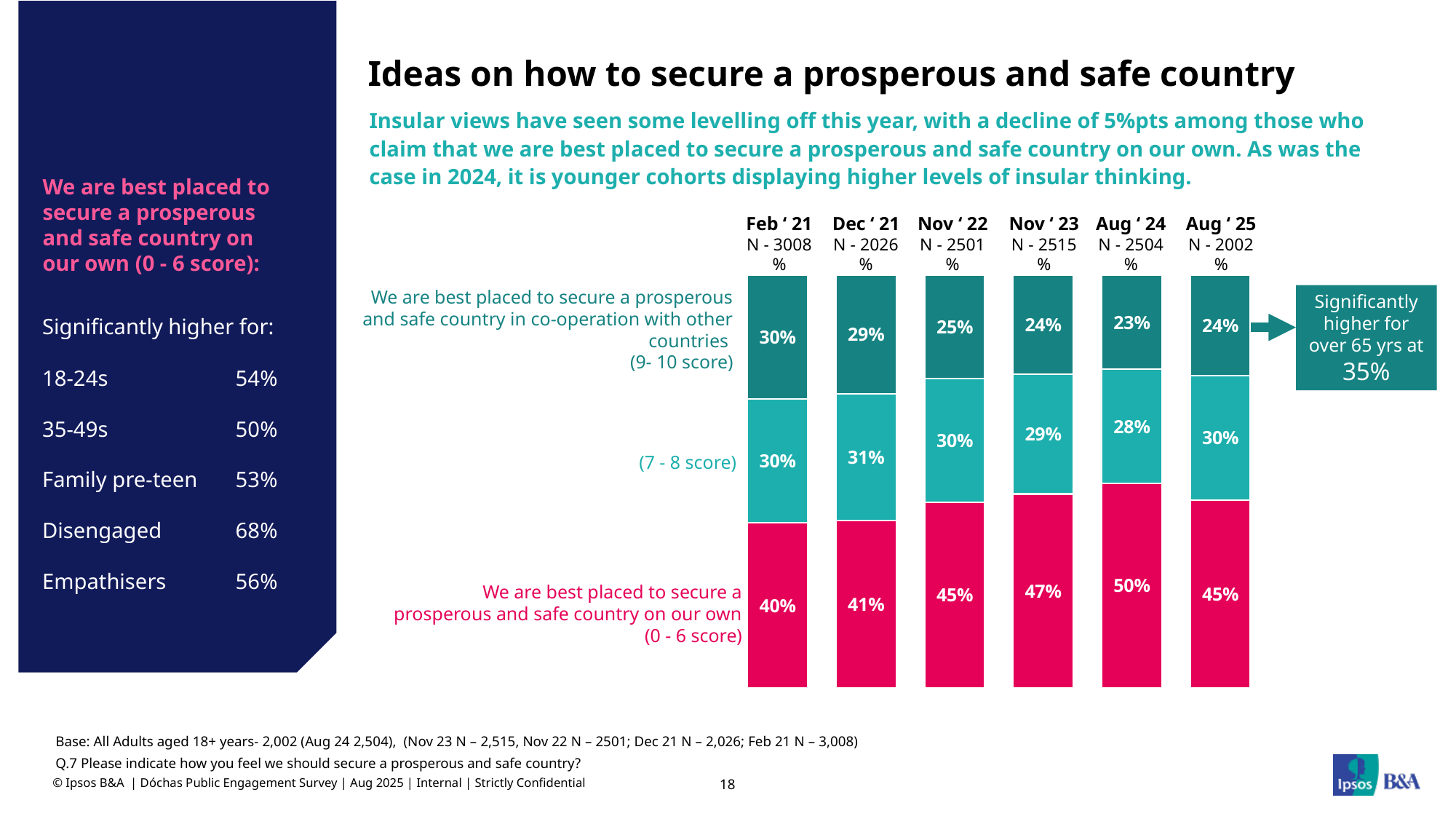
Which is larger: the 0-6 score share in Nov '23 or in Nov '22? Nov '23 What percentage scored 9-10 (co-operation with other countries) in Feb '21? 30% What percentage scored 0-6 (best placed on our own) in Aug '25? 45% What is the sample size (N) for the Aug '25 wave? 2002 How many survey waves are shown in the chart? 6 How many score bands (series) are stacked in each bar? 3 What is the total of the stacked bar for Nov '22? 100% By how many percentage points did the 0-6 score share change from Aug '24 to Aug '25? 5 percentage points lower What type of chart is shown on the slide? Stacked bar chart In which wave was the 9-10 score (co-operation) share lowest? Aug '24 What percentage scored 7-8 in Dec '21? 31% In which wave was the 0-6 score (on our own) share highest? Aug '24